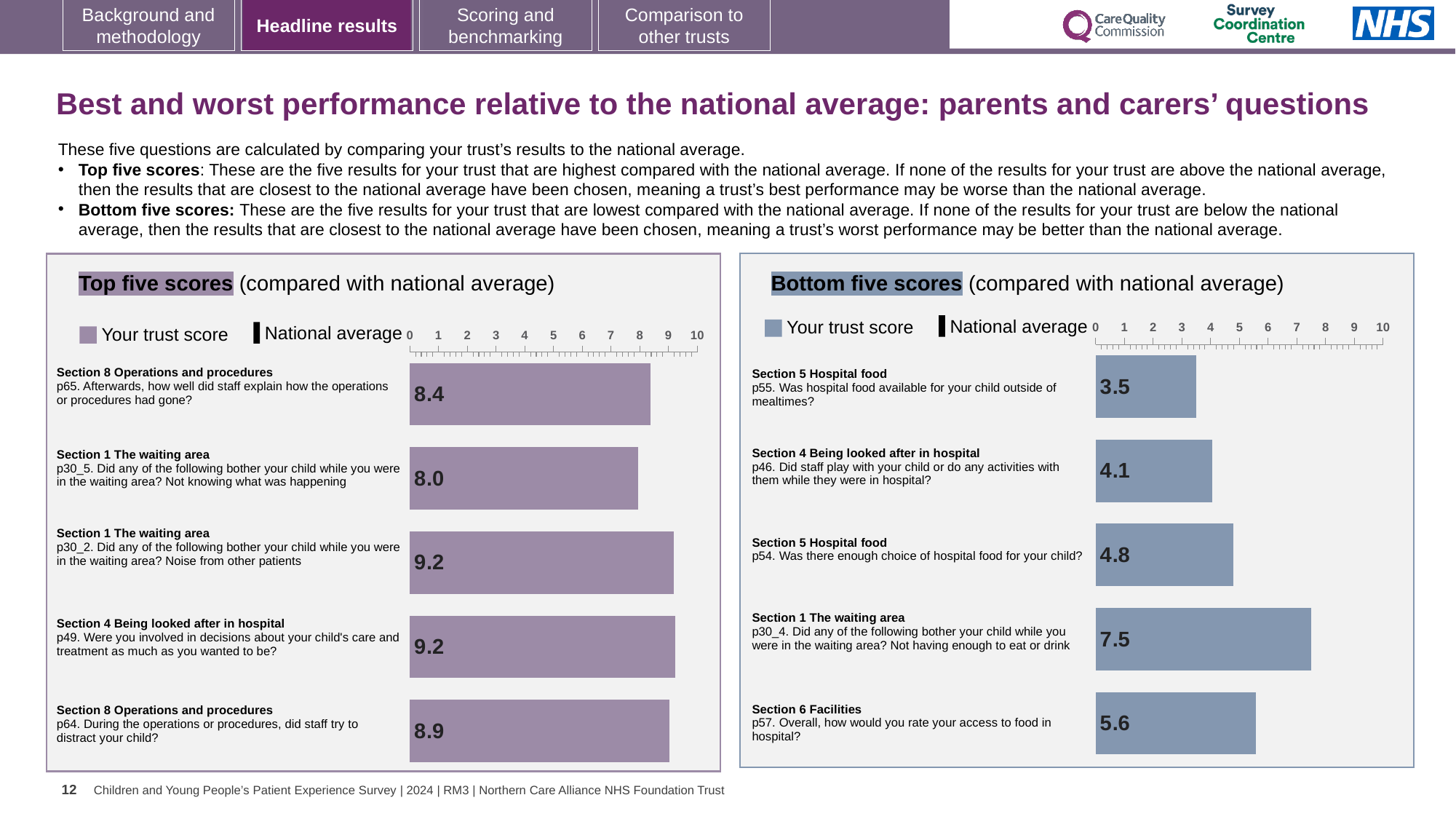
In the Top five scores chart, what is the difference between the score for p30_2 (Noise from other patients) and the score for p30_5 (Not knowing what was happening)? 1.2 In the Bottom five scores chart, what is the trust score for p55 (was hospital food available outside of mealtimes)? 3.5 In the Bottom five scores chart, what is the trust score for p30_4 (Not having enough to eat or drink)? 7.5 In the Bottom five scores chart, which question has the lowest trust score? p55. Was hospital food available for your child outside of mealtimes? (3.5) In the Bottom five scores chart, what is the difference between the score for p30_4 and the score for p55? 4.0 In the Top five scores chart, what is the trust score for p64 (did staff try to distract your child during operations or procedures)? 8.9 How many questions are plotted in the Top five scores chart? 5 In the Top five scores chart, which question has the lowest trust score? p30_5. Not knowing what was happening (8.0) What type of chart is used for the Bottom five scores? Bar chart In the Bottom five scores chart, which question has the highest trust score? p30_4. Not having enough to eat or drink (7.5) In the Top five scores chart, what is the trust score for p65 (how well did staff explain how the operations or procedures had gone)? 8.4 In the Bottom five scores chart, which has the higher trust score: p46 (did staff play with your child) or p54 (enough choice of hospital food)? p54 (4.8)